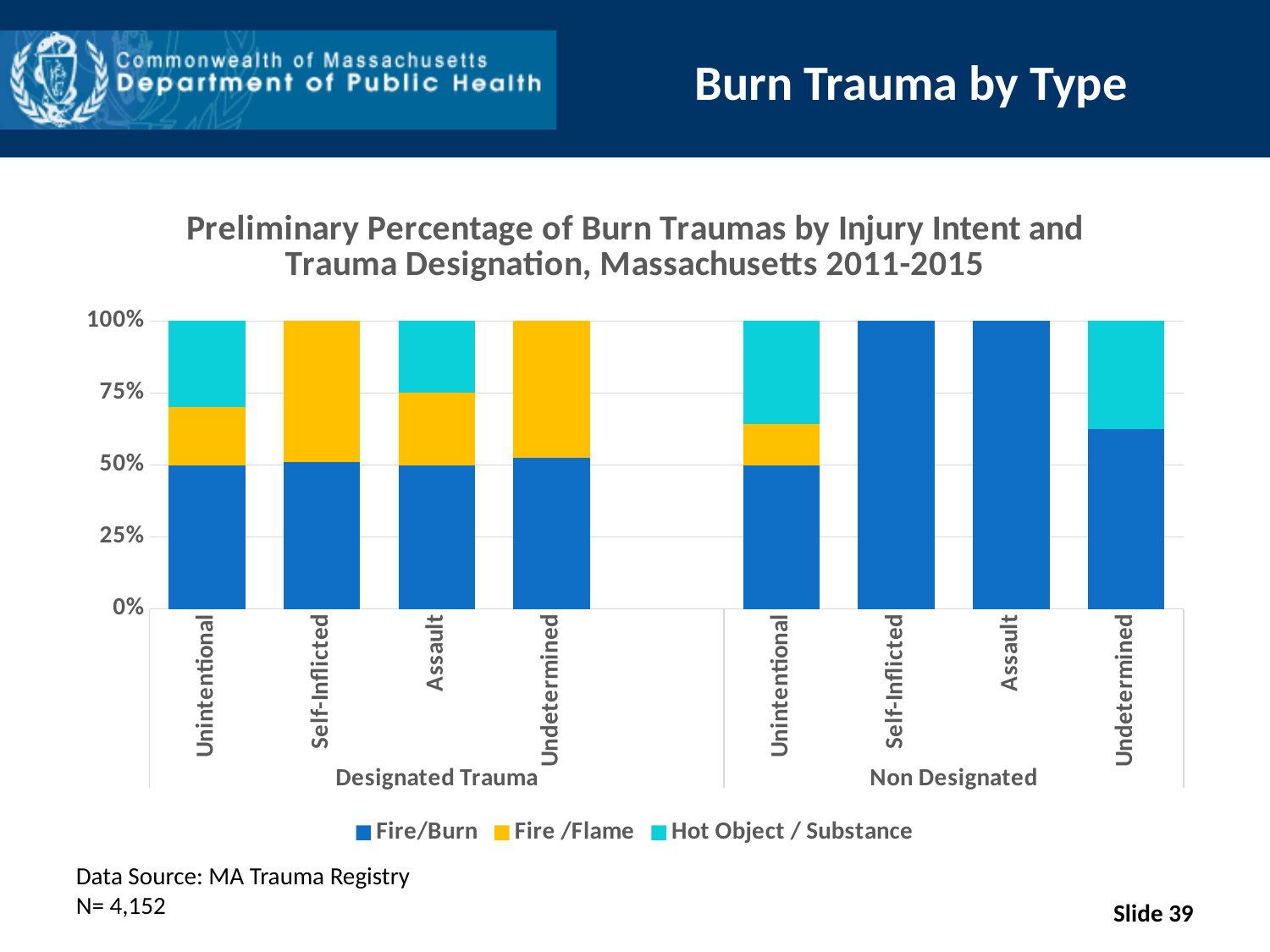
What is the Fire/Burn share for Assault in the Non Designated group? 100% Which series has the largest segment in the Unintentional bar of the Designated Trauma group? Fire/Burn What is the total of the stacked bar for Unintentional in the Designated Trauma group? 100% Which series is shown in yellow in the legend? Fire /Flame How many series does the legend list? 3 What kind of chart is shown on the slide? Stacked bar chart Is the Fire/Burn share for Undetermined in the Non Designated group greater or less than 50%? greater How many category bars are plotted in the chart? 8 What is the Fire/Burn share for Self-Inflicted in the Non Designated group? 100% What is the title of the chart? Preliminary Percentage of Burn Traumas by Injury Intent and Trauma Designation, Massachusetts 2011-2015 Is the Fire/Burn share for Self-Inflicted in the Designated Trauma group greater or less than 75%? less Which is larger, the Fire/Burn share for Undetermined in Designated Trauma or the Fire/Burn share for Undetermined in Non Designated? Undetermined in Non Designated